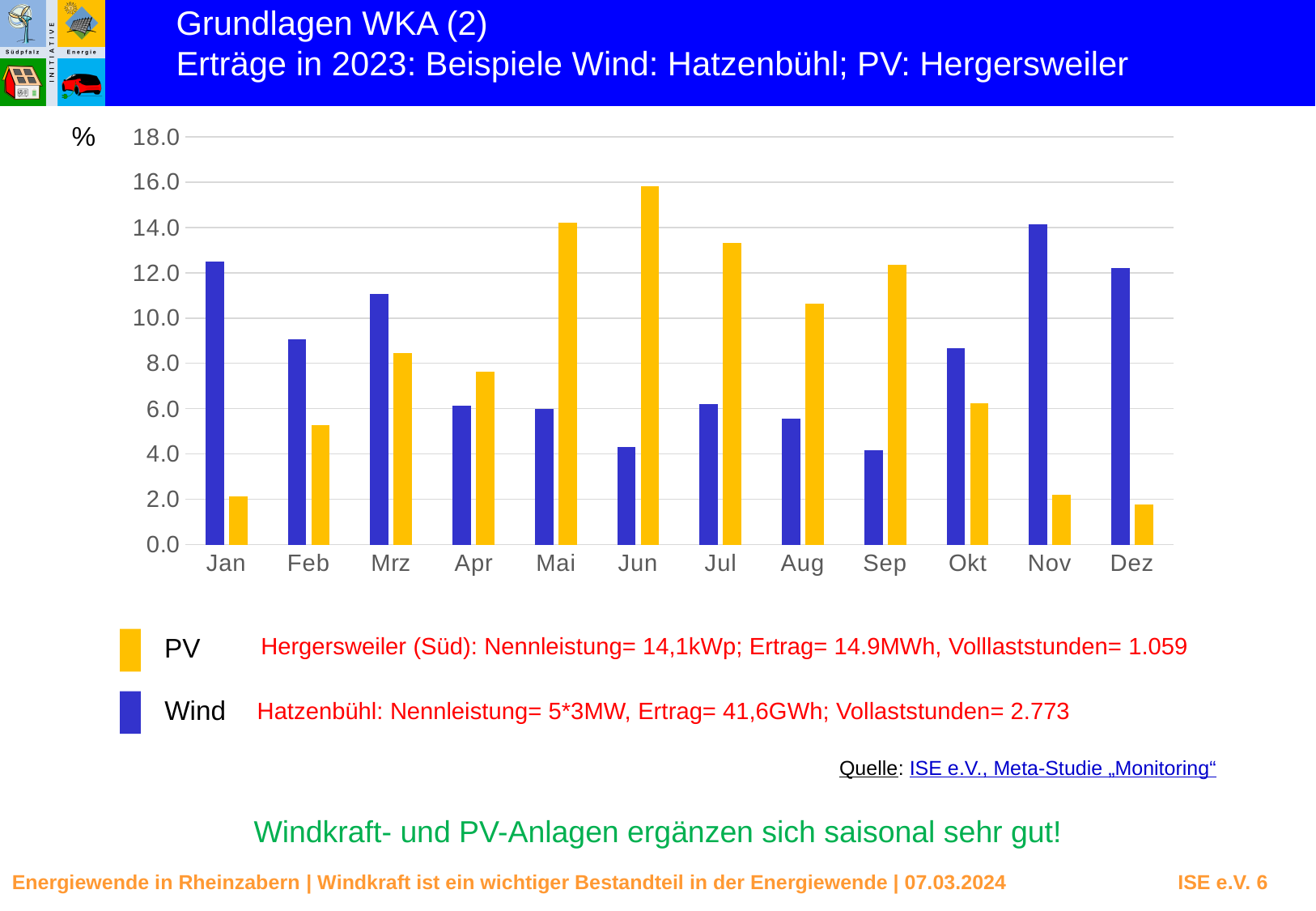
Is the PV value for Jun greater or less than 14.0? greater In which month is the PV value highest? Jun In Jan, which series has the larger value, PV or Wind? Wind How many months are shown on the x axis? 12 In which month is the PV value lowest? Dez Is the PV value for Jan greater or less than 4.0? less In which month is the Wind value highest? Nov What kind of chart is shown on the slide? bar chart How many series does the legend list? 2 Is the Wind value for Jun greater or less than 6.0? less What colour are the PV bars? yellow In Jun, which series has the larger value, PV or Wind? PV